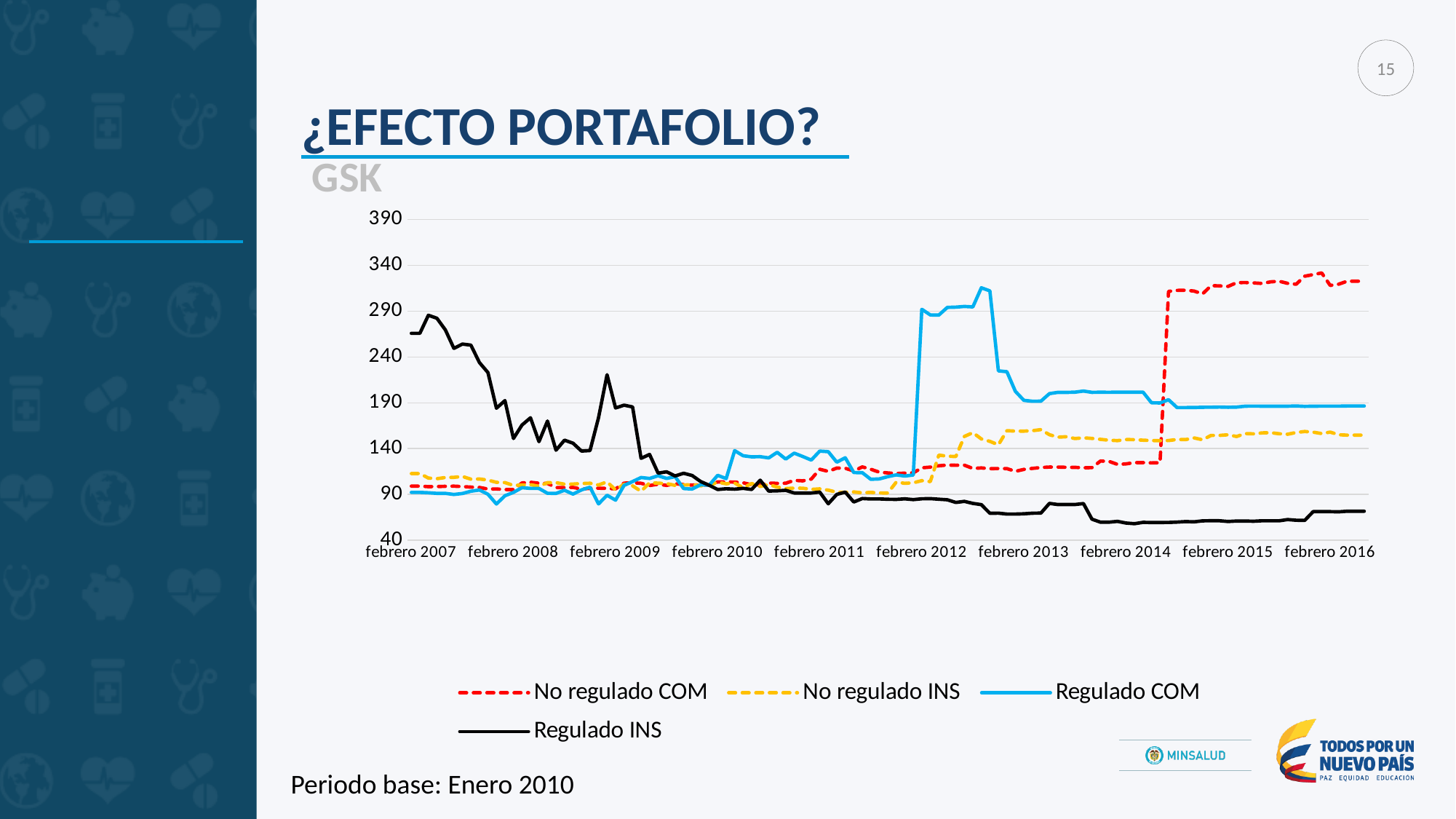
Does the No regulado COM series rise or fall overall from febrero 2007 to febrero 2016? rise Which series has the lowest value at febrero 2016? Regulado INS How many series does the legend list? 4 Is the value for Regulado COM at febrero 2016 greater or less than 140? greater Is the value for Regulado INS at febrero 2007 greater or less than 240? greater Is the value for Regulado INS at febrero 2016 greater or less than 90? less At febrero 2016, which series is higher: No regulado COM or Regulado COM? No regulado COM What kind of chart is shown on the slide? line chart Does the Regulado INS series rise or fall overall from febrero 2007 to febrero 2016? fall What colour is the Regulado COM line in the legend? blue Which series has the highest value at febrero 2016? No regulado COM